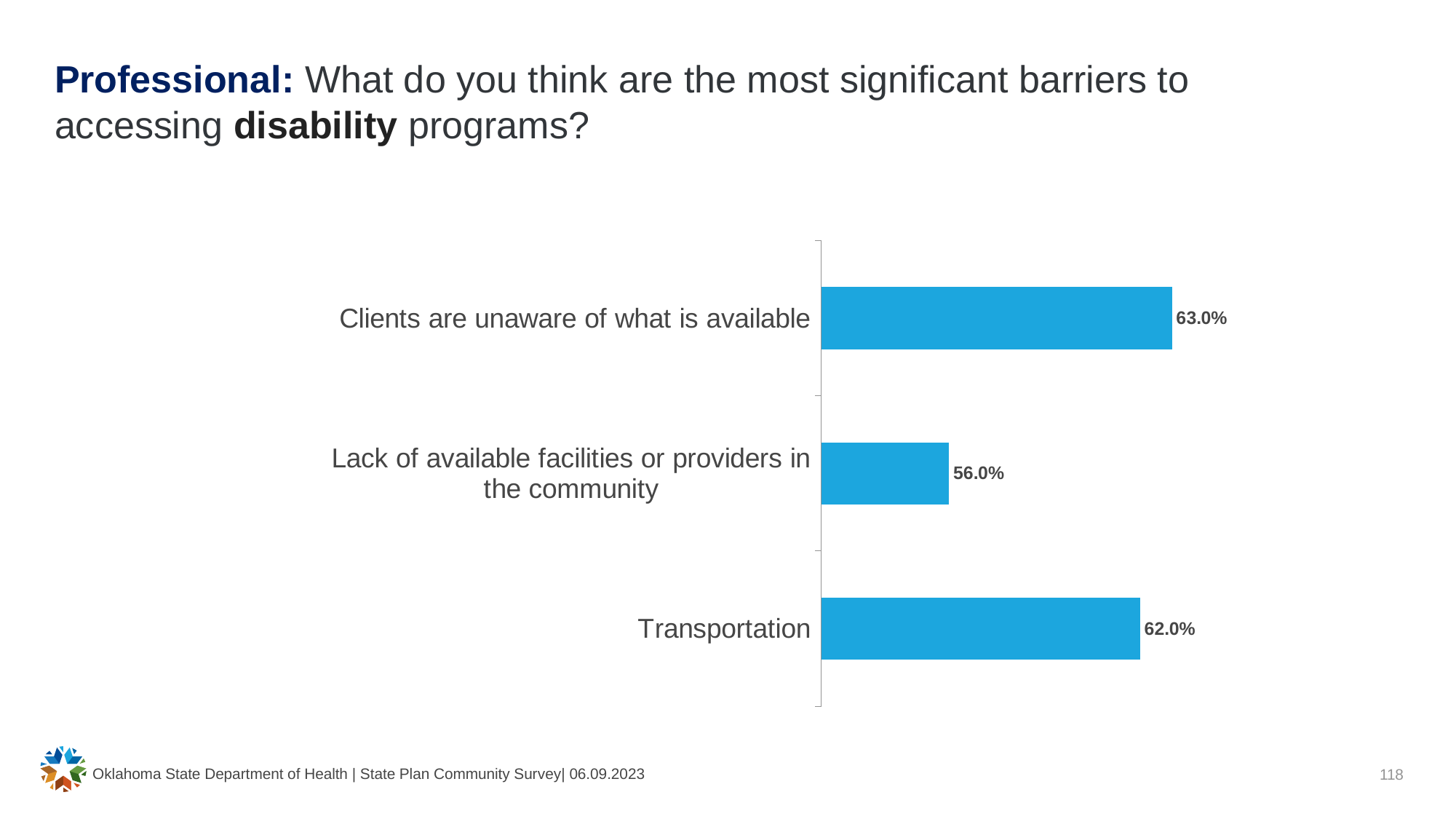
Which has a larger value: 'Transportation' or 'Lack of available facilities or providers in the community'? Transportation Which barrier has the lowest percentage on the chart? Lack of available facilities or providers in the community What type of chart is shown on the slide? Bar chart What is the value shown for 'Transportation'? 62.0% Which group of respondents does the slide title say answered this question? Professional What is the difference in percentage points between 'Transportation' and 'Lack of available facilities or providers in the community'? 6.0% How many barrier categories are shown on the chart? 3 What colour are the bars in the chart? Blue What percentage of professionals cited 'Clients are unaware of what is available' as a barrier to accessing disability programs? 63.0% Which barrier has the highest percentage on the chart? Clients are unaware of what is available What is the value shown for 'Lack of available facilities or providers in the community'? 56.0% What is the difference in percentage points between 'Clients are unaware of what is available' and 'Lack of available facilities or providers in the community'? 7.0%